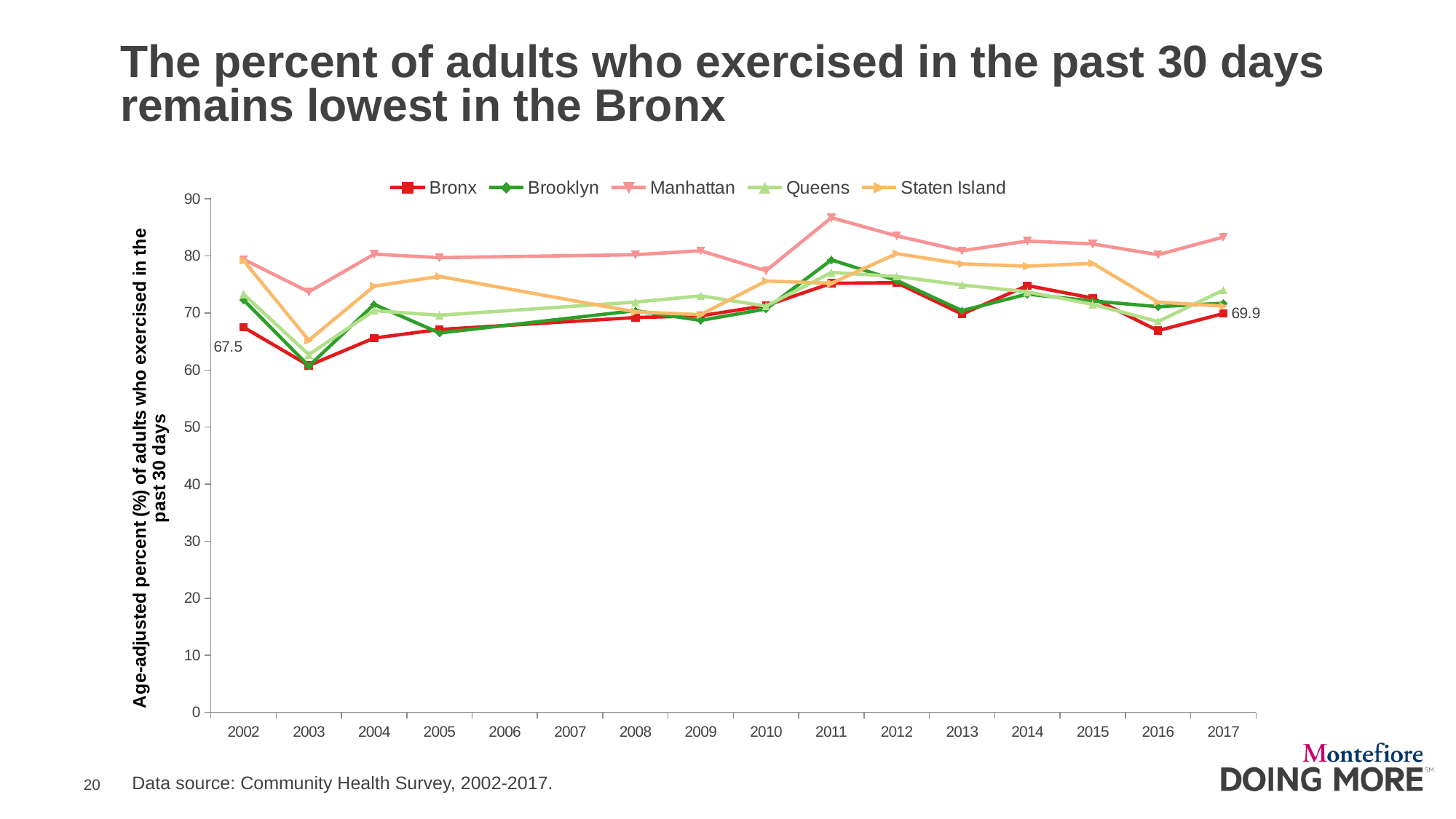
Which borough has the lowest value in 2002? Bronx Which is larger in 2012, the value for Manhattan or the value for the Bronx? Manhattan Does the Bronx value rise or fall from 2002 to 2003? fall What kind of chart is shown on the slide? Line chart What colour is the Bronx line in the chart? Red How many series does the legend list? 5 Which borough has the highest value in 2011? Manhattan What is the value for the Bronx in 2017? 69.9 Is the value for Manhattan in 2011 greater or less than 80? greater Is the value for the Bronx in 2003 greater or less than 70? less By how much did the Bronx value change from 2002 to 2017? 2.4 What is the value for the Bronx in 2002? 67.5